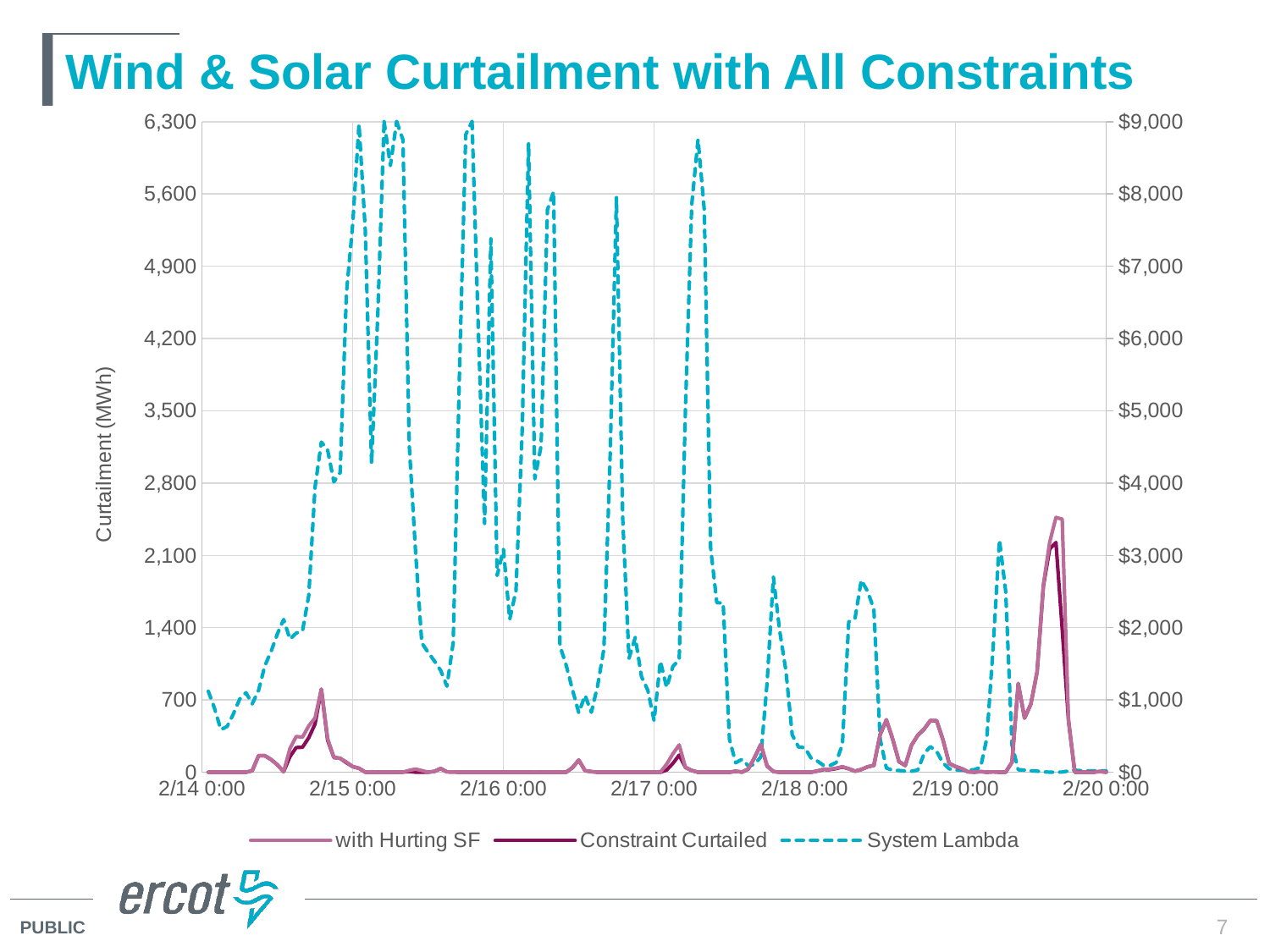
What kind of chart is shown on the slide? line chart What is the title of the chart? Wind & Solar Curtailment with All Constraints Is the peak value of the 'Constraint Curtailed' series on 2/19 greater or less than 1,400 MWh? greater Which series in the legend is drawn with a dashed line? System Lambda What is the label of the left vertical axis? Curtailment (MWh) What is the highest value shown on the right vertical axis? $9,000 Is the peak value of the 'with Hurting SF' series on 2/19 greater or less than 2,800 MWh? less Is the peak value of the 'with Hurting SF' series on 2/19 greater or less than 2,100 MWh? greater How many date labels are shown along the x axis? 7 At the peak on 2/19, which series is higher: 'with Hurting SF' or 'Constraint Curtailed'? with Hurting SF What is the highest value shown on the left vertical axis? 6,300 How many series does the legend list? 3